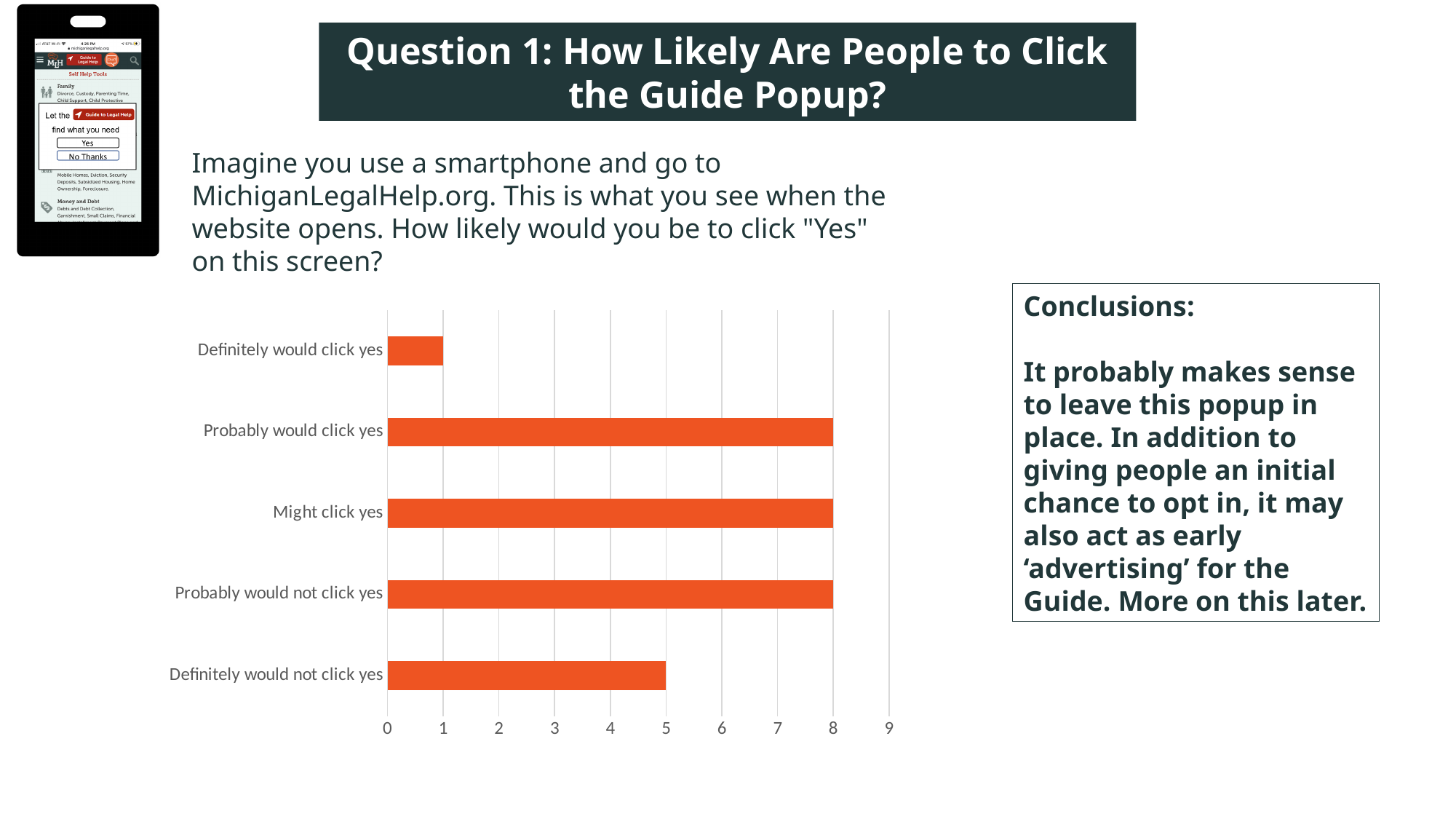
What kind of chart is shown on the slide? bar chart Which is larger, the value for "Definitely would not click yes" or the value for "Definitely would click yes"? Definitely would not click yes Is the value for "Definitely would not click yes" greater or less than 3? greater What is the value for "Definitely would click yes"? 1 What is the value for "Definitely would not click yes"? 5 How many categories does the bar chart show? 5 Which category has the lowest value? Definitely would click yes What is the difference between the values for "Definitely would not click yes" and "Definitely would click yes"? 4 What is the highest value shown on the x axis of the chart? 9 What is the value for "Probably would not click yes"? 8 What is the difference between the values for "Probably would click yes" and "Definitely would not click yes"? 3 What is the value for "Might click yes"? 8